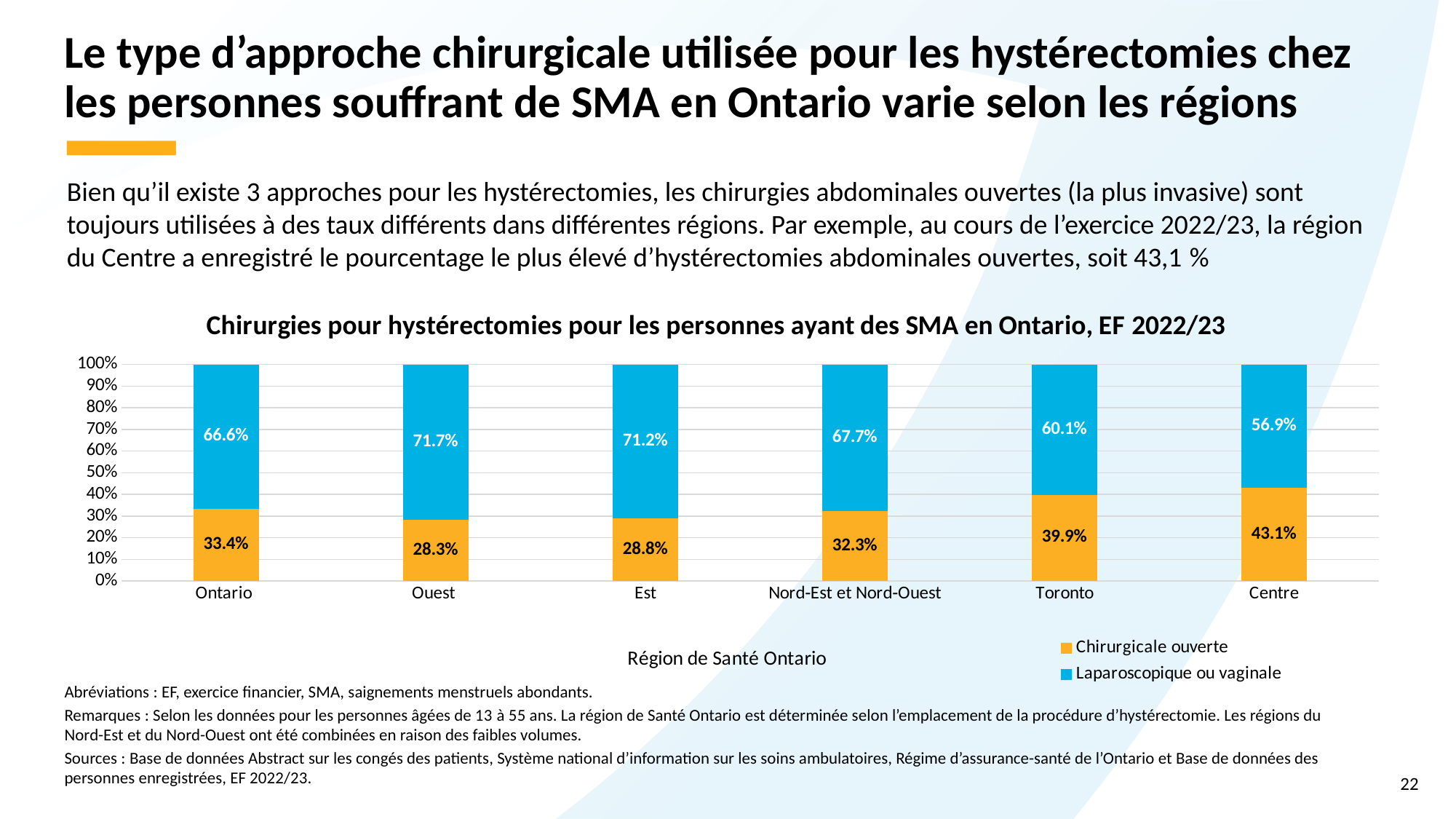
How many series does the legend list? 2 What is the value for Chirurgicale ouverte in Toronto? 39.9% What is the title of the chart? Chirurgies pour hystérectomies pour les personnes ayant des SMA en Ontario, EF 2022/23 What is the difference between the Chirurgicale ouverte values for Centre and Ouest? 14.8% What is the value for Chirurgicale ouverte in Centre? 43.1% Which is larger: the Chirurgicale ouverte value for Ontario or for Est? Ontario What is the value for Laparoscopique ou vaginale in Ouest? 71.7% How many regions are shown on the x axis? 6 What kind of chart is shown? Stacked bar chart Which region has the lowest value for Chirurgicale ouverte? Ouest Which region has the highest value for Chirurgicale ouverte? Centre Which region has the highest value for Laparoscopique ou vaginale? Ouest